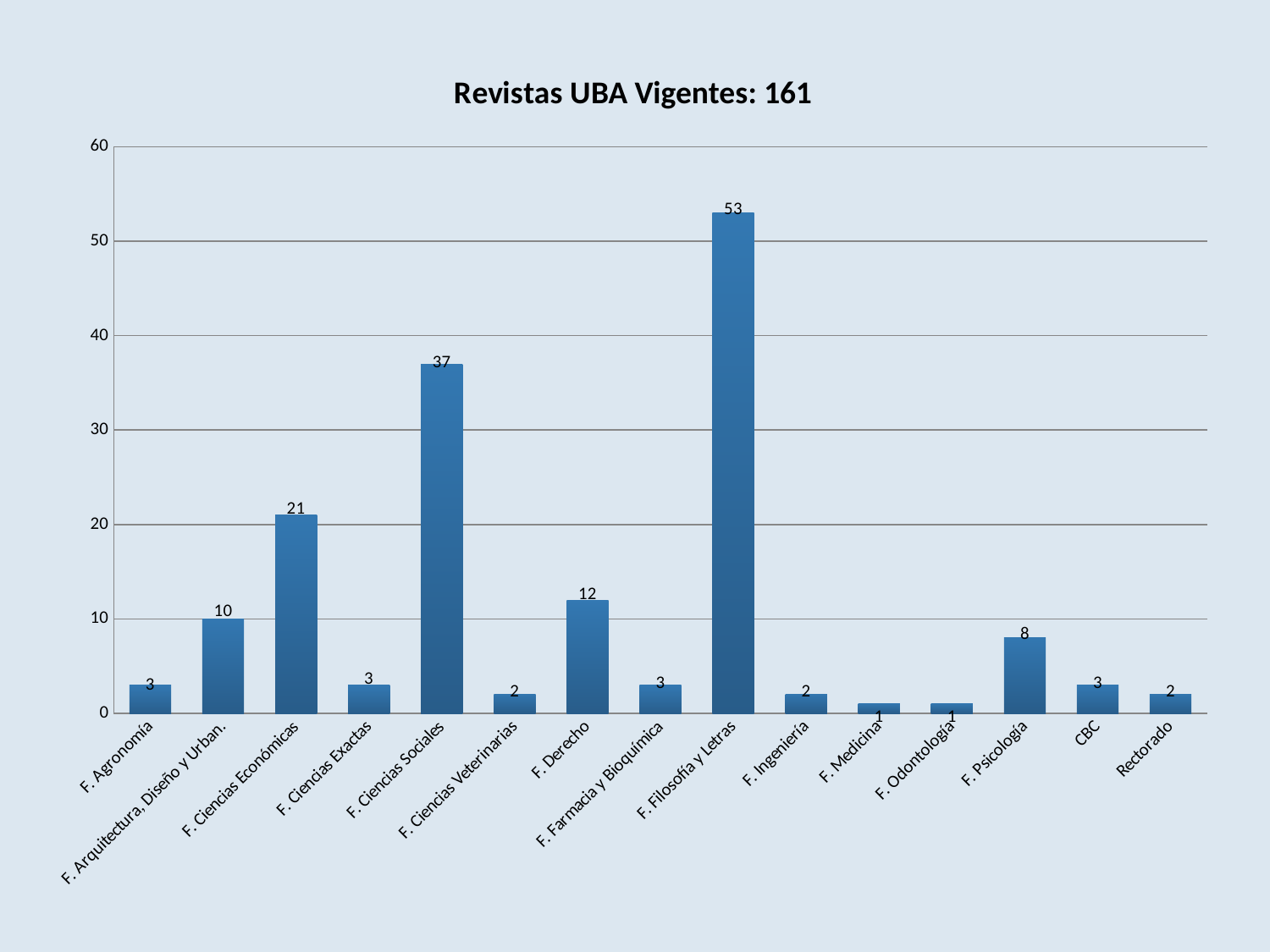
What is the value for F. Ciencias Sociales? 37 Which category has the highest value? F. Filosofía y Letras What is the value for F. Psicología? 8 What is the difference between the values for F. Filosofía y Letras and F. Ciencias Sociales? 16 What is the difference between the values for F. Ciencias Económicas and F. Arquitectura, Diseño y Urban.? 11 Is the value for F. Ciencias Sociales greater or less than 30? greater What kind of chart is shown on the slide? bar chart What is the value for F. Derecho? 12 How many categories are shown on the x axis? 15 Which is larger, the value for F. Derecho or the value for F. Psicología? F. Derecho What is the title of the chart? Revistas UBA Vigentes: 161 What is the value for F. Filosofía y Letras? 53